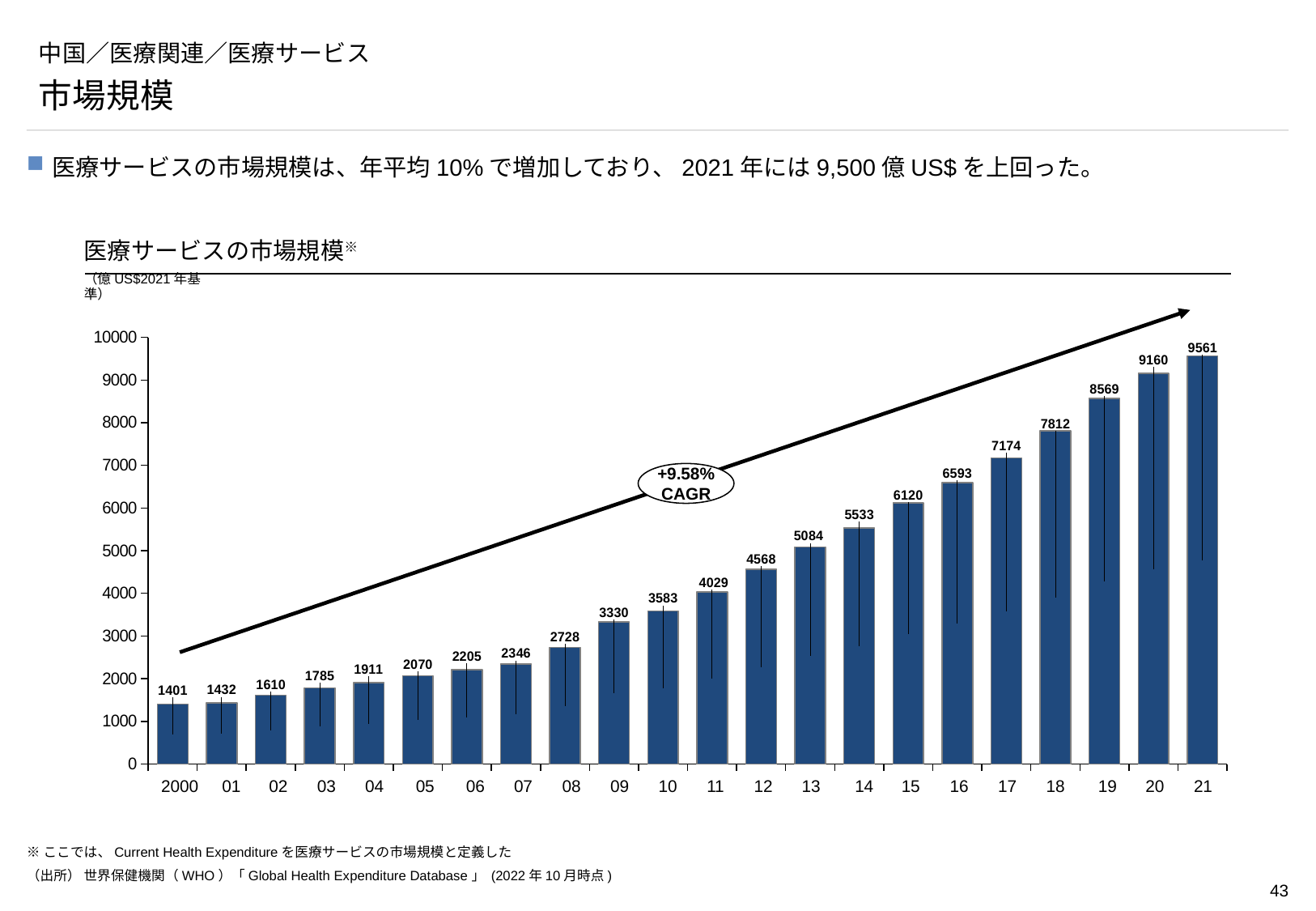
What is the value for 2015 in the chart? 6120 Do the values rise or fall from 2000 to 2021? rise What is the value for 2010 in the chart? 3583 Which year has the lowest value in the chart? 2000 Which is larger, the value for 2008 or the value for 2009? 2009 Is the value for 2017 greater or less than 7000? greater What is the difference between the values for 2021 and 2020? 401 Which year has the highest value in the chart? 21 What kind of chart is shown on the slide? bar chart What is the value for 2021 in the chart? 9561 How many years are plotted in the chart? 22 What is the value for 2000 in the chart? 1401